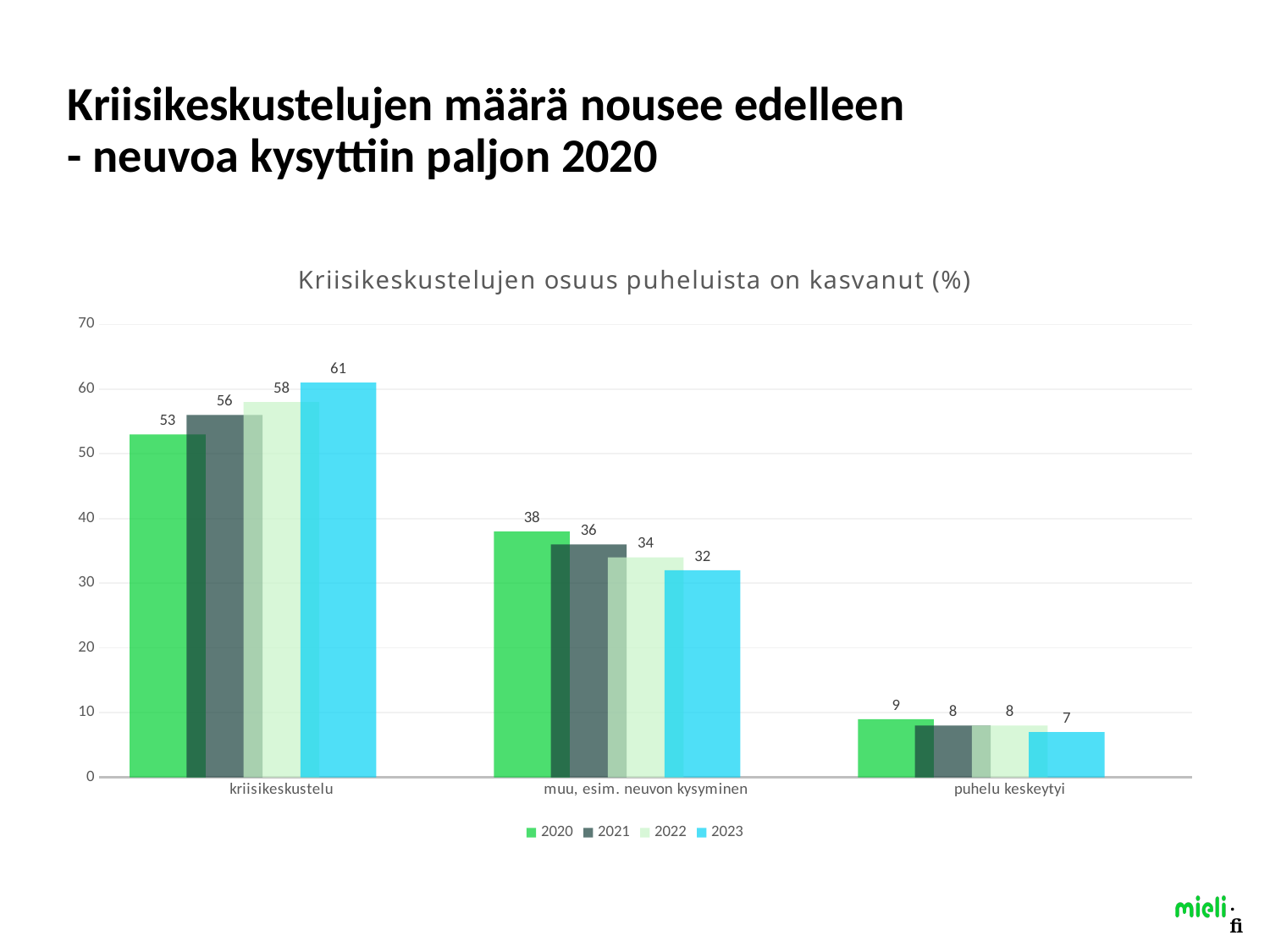
What is the title of the chart? Kriisikeskustelujen osuus puheluista on kasvanut (%) How many series does the legend list? 4 Is the value for kriisikeskustelu in 2020 greater or less than 50? greater What is the value for muu, esim. neuvon kysyminen in 2020? 38 Which category has the lowest value in 2020? puhelu keskeytyi What is the difference between the 2023 and 2020 values for kriisikeskustelu? 8 Which category has the highest value in 2022? kriisikeskustelu How many categories are shown on the x axis? 3 What kind of chart is shown on the slide? bar chart What is the value for kriisikeskustelu in 2023? 61 Which is larger for muu, esim. neuvon kysyminen: the 2021 value or the 2023 value? 2021 What is the value for puhelu keskeytyi in 2021? 8